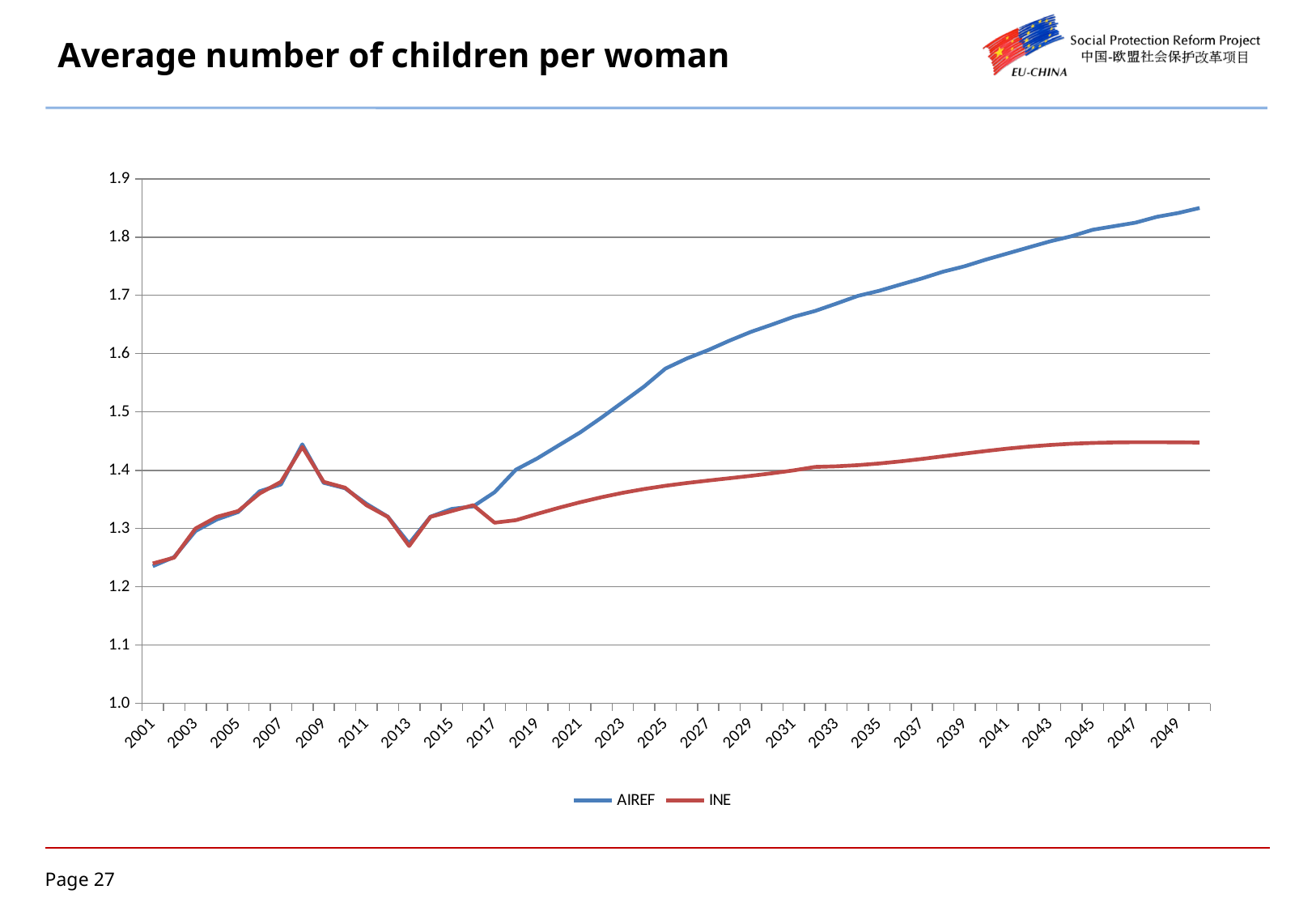
Is the AIREF value for 2025 greater or less than 1.5? greater Is the AIREF value for 2049 greater or less than 1.8? greater Does the AIREF series rise or fall between 2019 and 2049? rise Is the INE value for 2013 greater or less than 1.3? less What kind of chart is shown on the slide? line chart In 2049, which series has the higher value, AIREF or INE? AIREF How many series does the legend list? 2 How many year labels are shown on the x axis? 25 Which series is drawn in blue? AIREF What is the title of the chart? Average number of children per woman